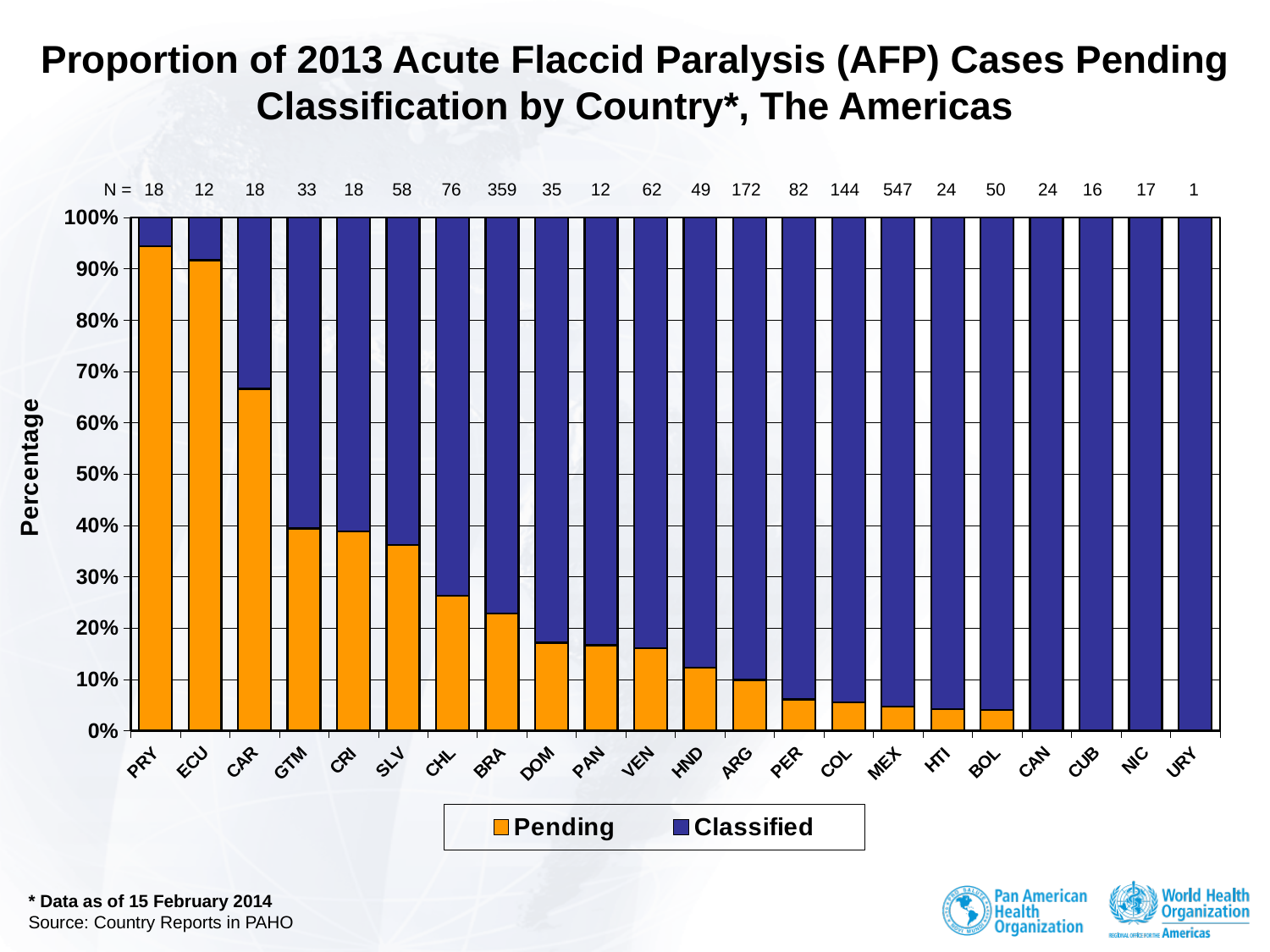
How many countries are shown along the x axis of the chart? 22 Which has a larger pending proportion, CAR or GTM? CAR Which country has the highest proportion of pending AFP cases? PRY What is the N value shown for MEX? 547 Which colour represents the Pending series in the legend? Orange Does the pending proportion rise or fall moving from left to right along the x axis? fall Is the pending proportion for CHL greater or less than 30%? less What is the N value shown for BRA? 359 How many series does the legend list? 2 What kind of chart is shown on the slide? Stacked bar chart Is the pending proportion for PRY greater or less than 90%? greater Is the pending proportion for CAR greater or less than 60%? greater